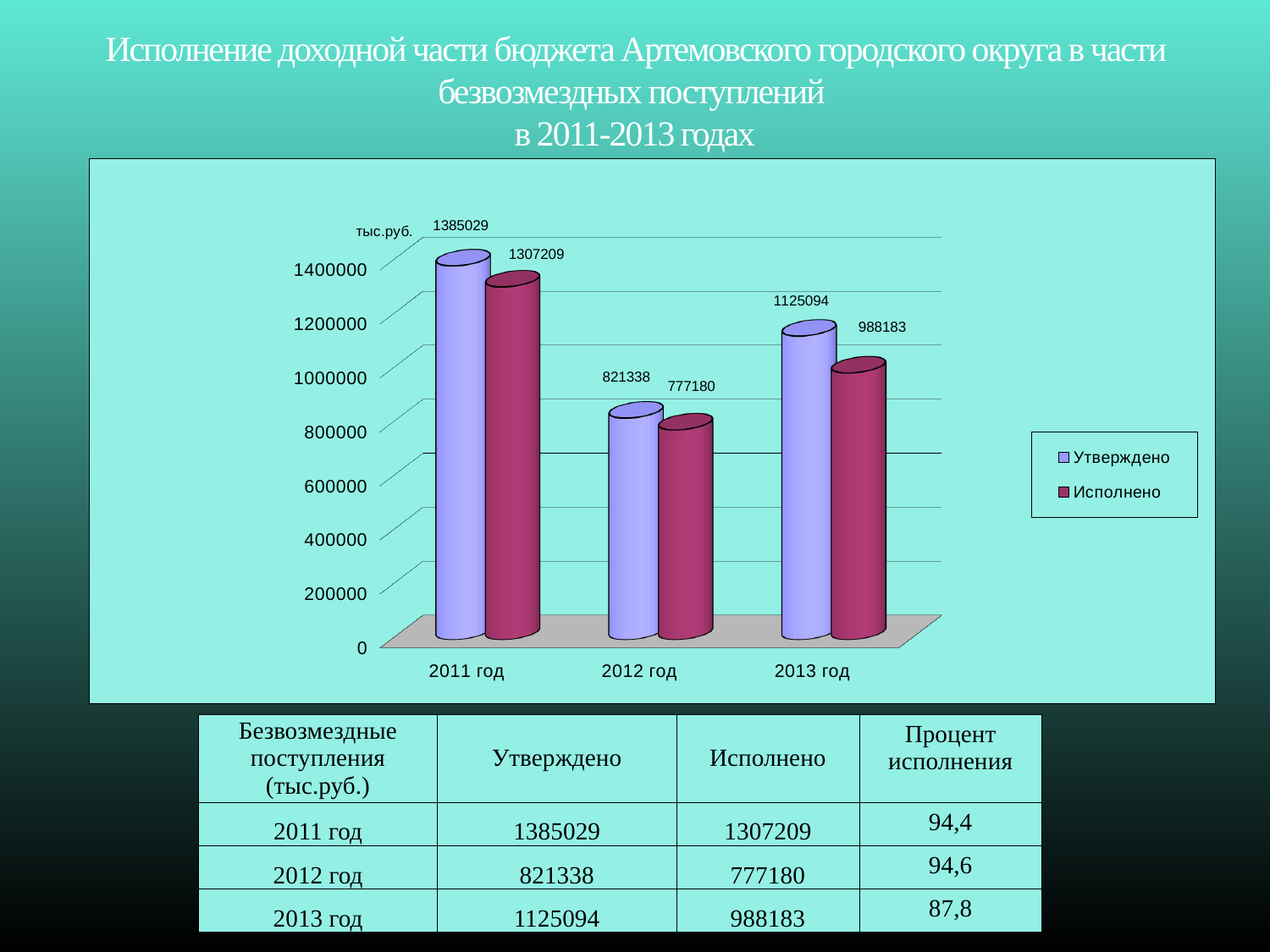
How many years are shown on the x axis of the chart? 3 Which is larger: Исполнено for 2011 год or Утверждено for 2013 год? Исполнено for 2011 год What is the difference between Утверждено and Исполнено for 2011 год? 77820 Which year has the lowest Исполнено value? 2012 год What is the difference between Утверждено and Исполнено for 2013 год? 136911 What type of chart is shown on the slide? bar chart What is the value of Исполнено for 2013 год? 988183 What is the value of Исполнено for 2012 год? 777180 What is the value of Утверждено for 2011 год? 1385029 Which year has the highest Утверждено value? 2011 год Is the Утверждено value for 2012 год greater or less than 1000000? less How many series does the chart legend list? 2